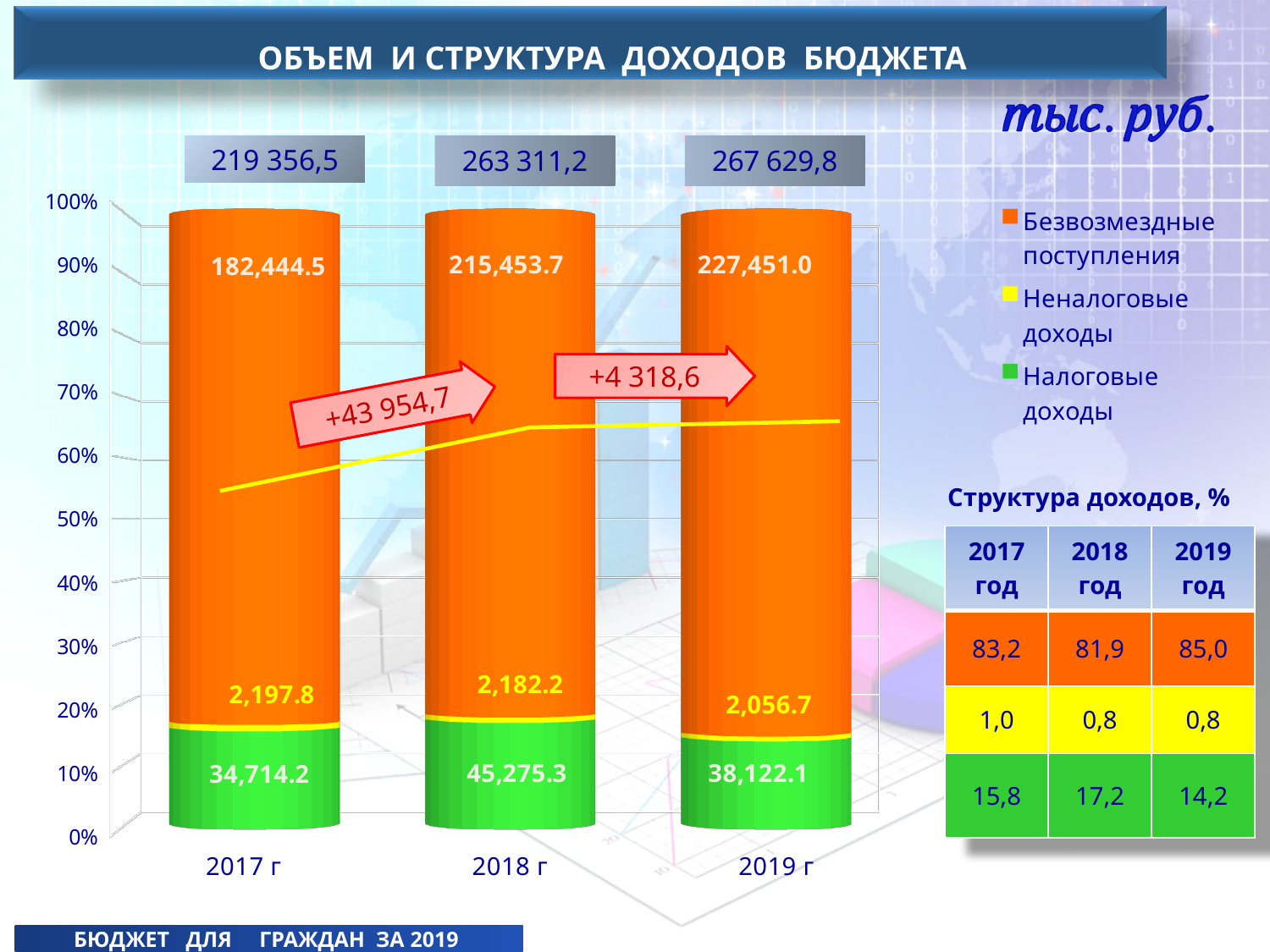
What is the difference between Налоговые доходы in 2018 г and 2017 г? 10,561.1 What is the value of Безвозмездные поступления for 2017 г? 182,444.5 Do the values of Безвозмездные поступления rise or fall from 2017 г to 2019 г? Rise How many series does the chart legend list? 3 What is the value of Налоговые доходы for 2018 г? 45,275.3 Which is larger: Безвозмездные поступления in 2018 г or in 2019 г? 2019 г How many years (categories) are shown on the x axis of the chart? 3 In which year is Налоговые доходы highest? 2018 г What kind of chart is shown on the slide? Stacked bar chart In which year is Неналоговые доходы lowest? 2019 г What total is printed above the 2018 г bar? 263 311,2 What is the value of Неналоговые доходы for 2019 г? 2,056.7